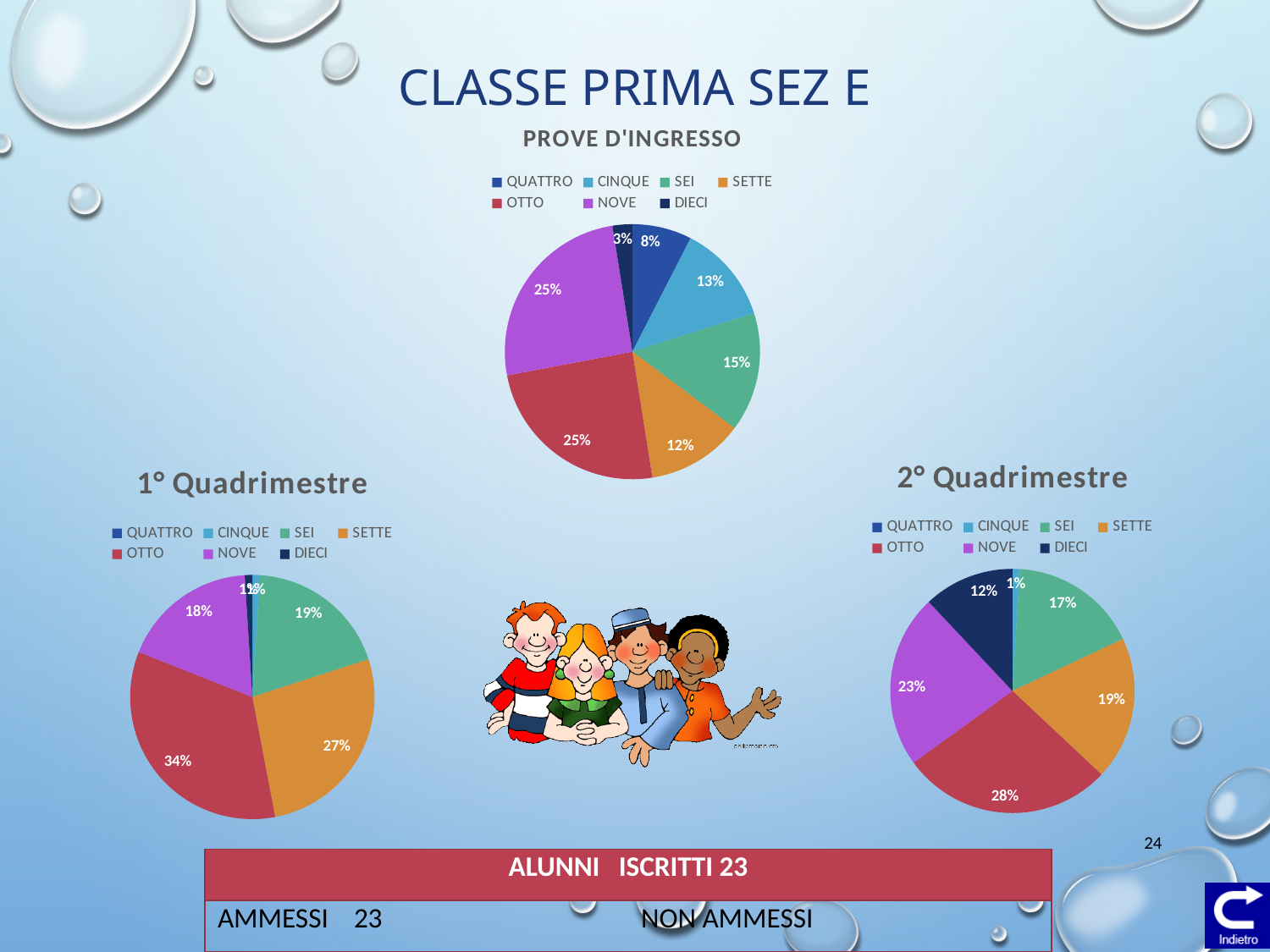
In the 1° Quadrimestre chart, what percentage is shown for OTTO? 34% How many entries does the legend of the PROVE D'INGRESSO chart list? 7 In the PROVE D'INGRESSO chart, what percentage is shown for SEI? 15% In the 1° Quadrimestre chart, which category has the largest slice? OTTO In the PROVE D'INGRESSO chart, what is the difference between the OTTO slice and the QUATTRO slice? 17 percentage points In the PROVE D'INGRESSO chart, which category has the smallest slice? DIECI In the PROVE D'INGRESSO chart, what percentage is shown for CINQUE? 13% In the 1° Quadrimestre chart, which is larger, SETTE or NOVE? SETTE How many pie charts are shown on the slide? 3 What kind of chart is the PROVE D'INGRESSO chart? pie chart In the 2° Quadrimestre chart, what is the difference between the NOVE slice and the SEI slice? 6 percentage points In the 2° Quadrimestre chart, what percentage is shown for DIECI? 12%